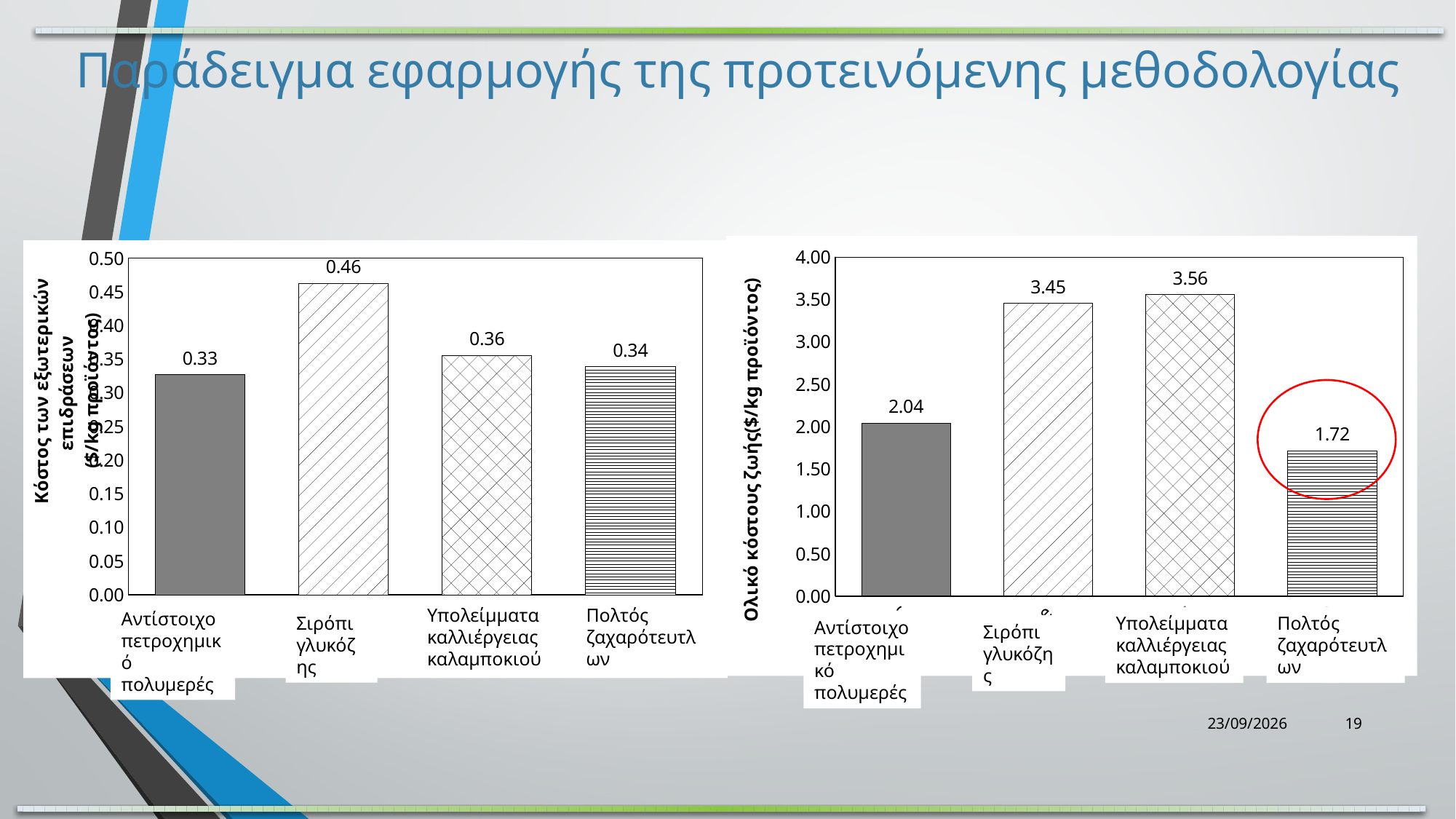
In the left chart, what is the value for Πολτός ζαχαρότευτλων? 0.34 In the right chart, what is the difference between the values for Σιρόπι γλυκόζης and Πολτός ζαχαρότευτλων? 1.73 In the right chart, which is larger: the value for Αντίστοιχο πετροχημικό πολυμερές or the value for Πολτός ζαχαρότευτλων? Αντίστοιχο πετροχημικό πολυμερές In the right chart, what is the value for Αντίστοιχο πετροχημικό πολυμερές? 2.04 In the left chart, what is the difference between the values for Σιρόπι γλυκόζης and Αντίστοιχο πετροχημικό πολυμερές? 0.13 In the right chart, which bar is circled in red? Πολτός ζαχαρότευτλων How many categories are shown in the left chart? 4 In the right chart, what is the value for Υπολείμματα καλλιέργειας καλαμποκιού? 3.56 What kind of chart is the right chart? Bar chart In the left chart, what is the value for Σιρόπι γλυκόζης? 0.46 In the left chart, which category has the highest value? Σιρόπι γλυκόζης In the right chart, which category has the lowest value? Πολτός ζαχαρότευτλων